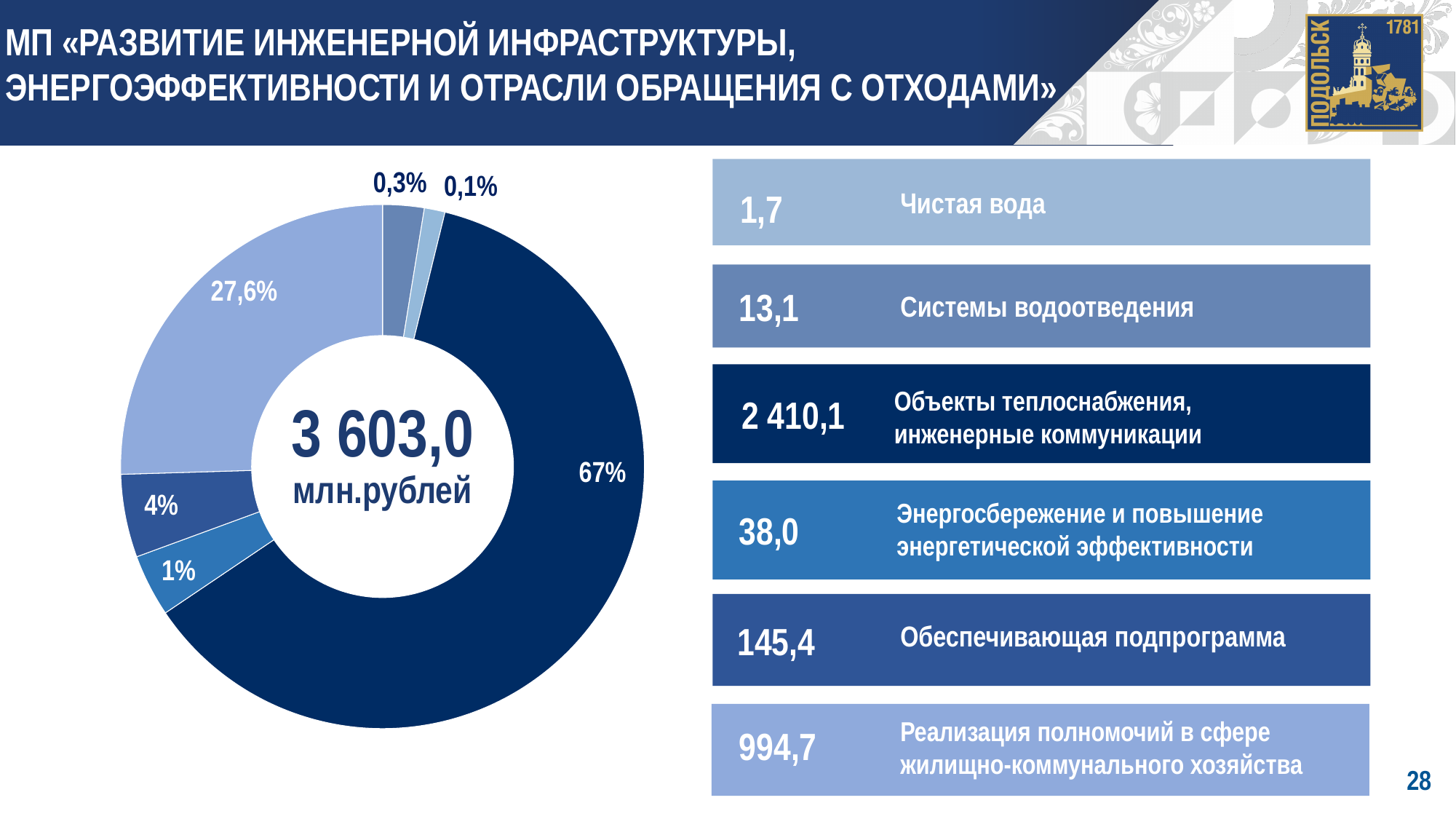
Which is larger: the value for «Системы водоотведения» or for «Энергосбережение и повышение энергетической эффективности»? Энергосбережение и повышение энергетической эффективности How many slices does the donut chart have? 6 How many categories are listed in the legend to the right of the donut chart? 6 What value is listed for «Объекты теплоснабжения, инженерные коммуникации»? 2 410,1 What is the smallest percentage shown on the donut chart? 0,1% What total value is shown in the centre of the donut chart? 3 603,0 млн.рублей What type of chart is shown on the slide? Pie chart (donut) What value is listed for «Обеспечивающая подпрограмма»? 145,4 What is the largest percentage shown on the donut chart? 67% What is the difference between the values for «Реализация полномочий в сфере жилищно-коммунального хозяйства» and «Обеспечивающая подпрограмма»? 849,3 What value is listed for «Чистая вода»? 1,7 What percentage is shown for the second-largest slice of the donut chart? 27,6%